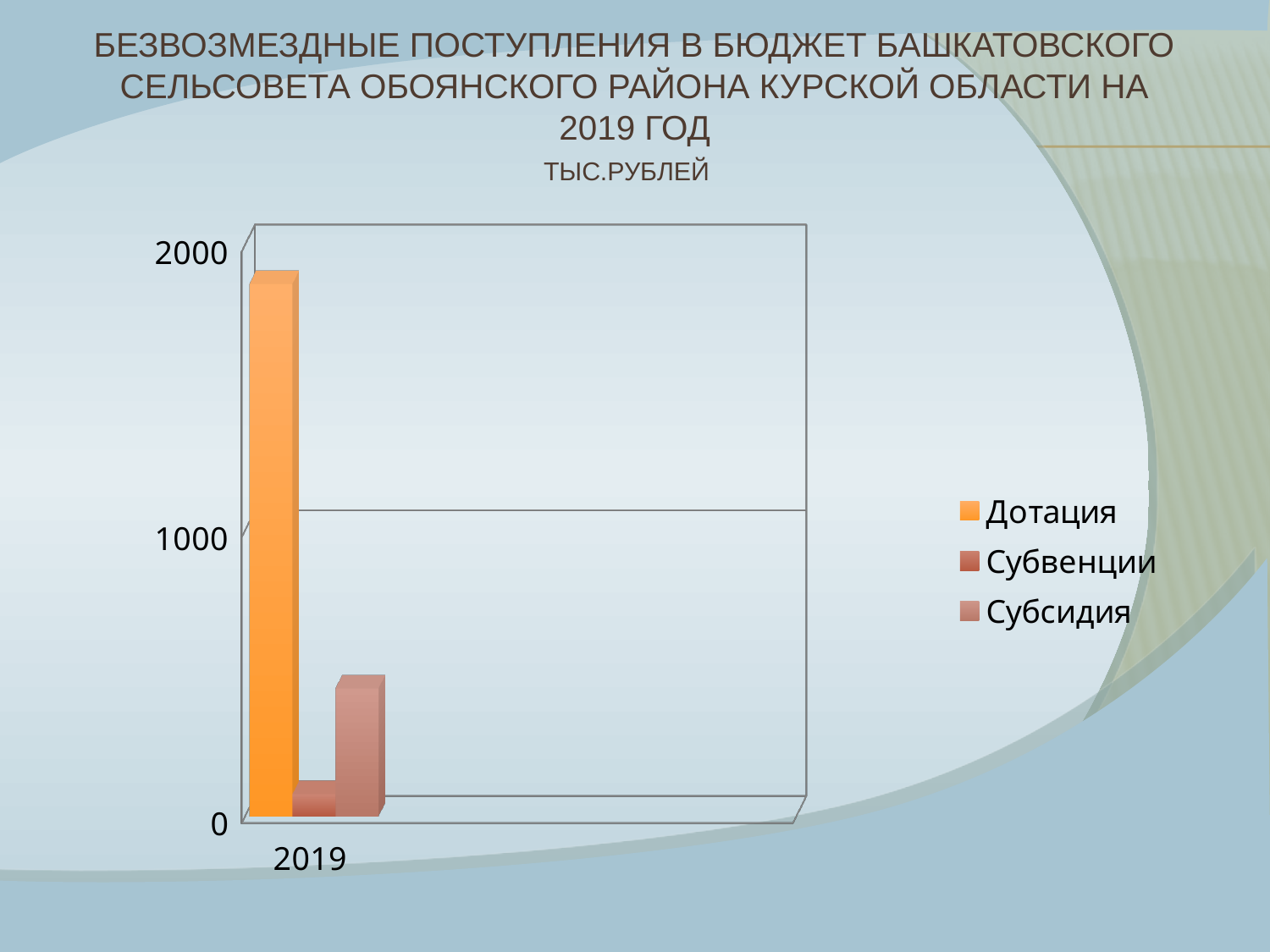
Is the value for Субсидия in 2019 greater or less than 1000? less Which series has the lowest value for 2019? Субвенции How many categories are shown on the x axis? 1 How many series does the legend list? 3 Which is larger for 2019, Субсидия or Субвенции? Субсидия Which series has the highest value for 2019? Дотация What kind of chart is shown on the slide? bar chart Which is larger for 2019, Дотация or Субсидия? Дотация Is the value for Дотация in 2019 greater or less than 1000? greater Which year is shown on the x axis of the chart? 2019 What unit of measurement is stated under the chart title? ТЫС.РУБЛЕЙ Is the value for Субвенции in 2019 greater or less than 1000? less